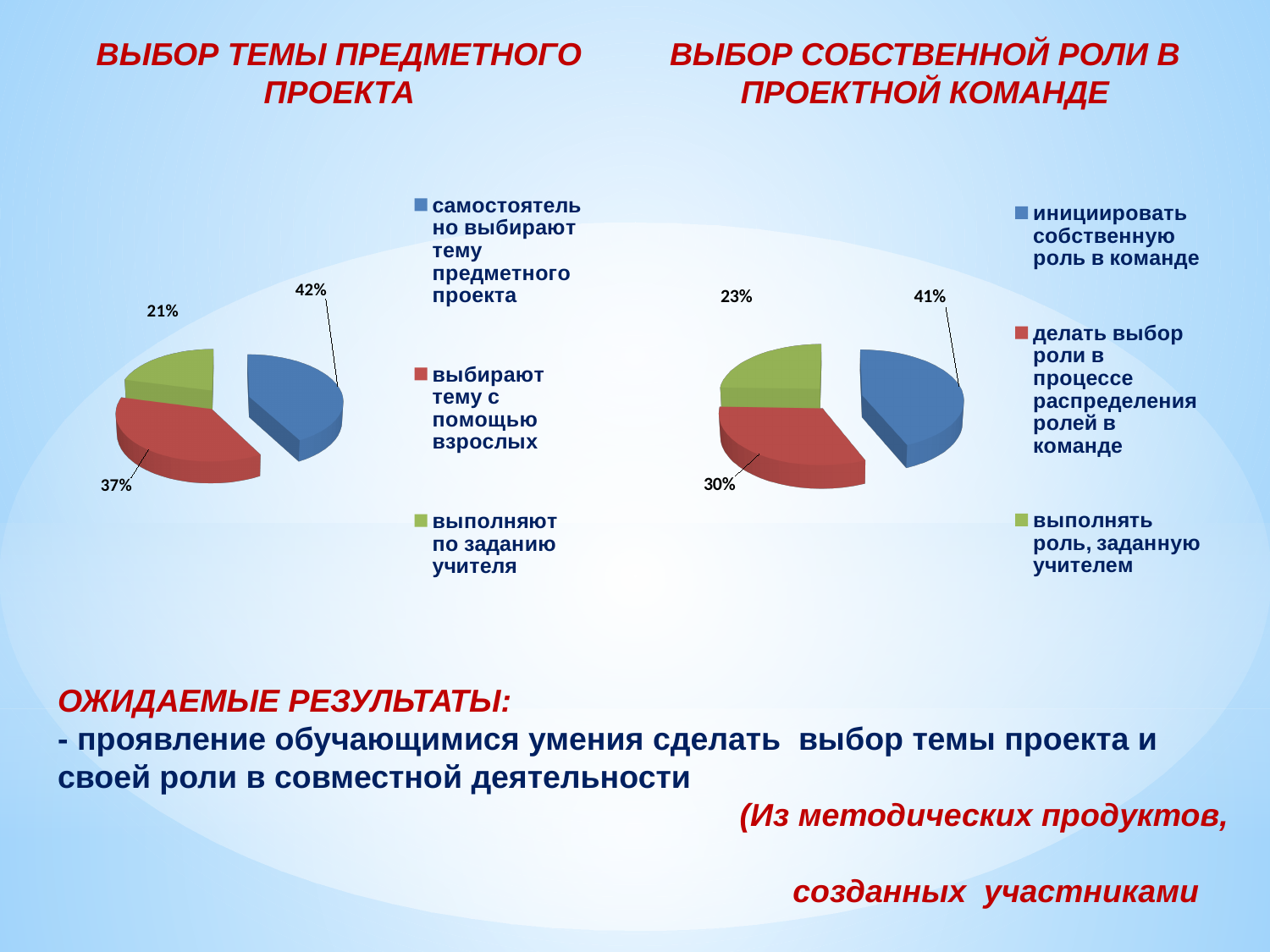
In the chart titled "ВЫБОР ТЕМЫ ПРЕДМЕТНОГО ПРОЕКТА", what percentage is shown for "выбирают тему с помощью взрослых"? 37% In the chart titled "ВЫБОР ТЕМЫ ПРЕДМЕТНОГО ПРОЕКТА", which category has the smallest share? выполняют по заданию учителя In the chart titled "ВЫБОР ТЕМЫ ПРЕДМЕТНОГО ПРОЕКТА", what percentage is shown for "самостоятельно выбирают тему предметного проекта"? 42% In the chart titled "ВЫБОР СОБСТВЕННОЙ РОЛИ В ПРОЕКТНОЙ КОМАНДЕ", what is the difference between "инициировать собственную роль в команде" and "делать выбор роли в процессе распределения ролей в команде"? 11% In the chart titled "ВЫБОР ТЕМЫ ПРЕДМЕТНОГО ПРОЕКТА", what colour is the slice for "выбирают тему с помощью взрослых"? Red In the chart titled "ВЫБОР ТЕМЫ ПРЕДМЕТНОГО ПРОЕКТА", what is the difference between the largest and smallest slices? 21% What type of chart is used on the left side of the slide? Pie chart In the chart titled "ВЫБОР СОБСТВЕННОЙ РОЛИ В ПРОЕКТНОЙ КОМАНДЕ", what percentage is shown for "выполнять роль, заданную учителем"? 23% In the chart titled "ВЫБОР СОБСТВЕННОЙ РОЛИ В ПРОЕКТНОЙ КОМАНДЕ", which category has the largest share? инициировать собственную роль в команде In the chart titled "ВЫБОР СОБСТВЕННОЙ РОЛИ В ПРОЕКТНОЙ КОМАНДЕ", what percentage is shown for "инициировать собственную роль в команде"? 41% Which is larger: the "выполняют по заданию учителя" slice in the left chart or the "выполнять роль, заданную учителем" slice in the right chart? выполнять роль, заданную учителем (right chart) In the chart titled "ВЫБОР СОБСТВЕННОЙ РОЛИ В ПРОЕКТНОЙ КОМАНДЕ", how many categories does the legend list? 3